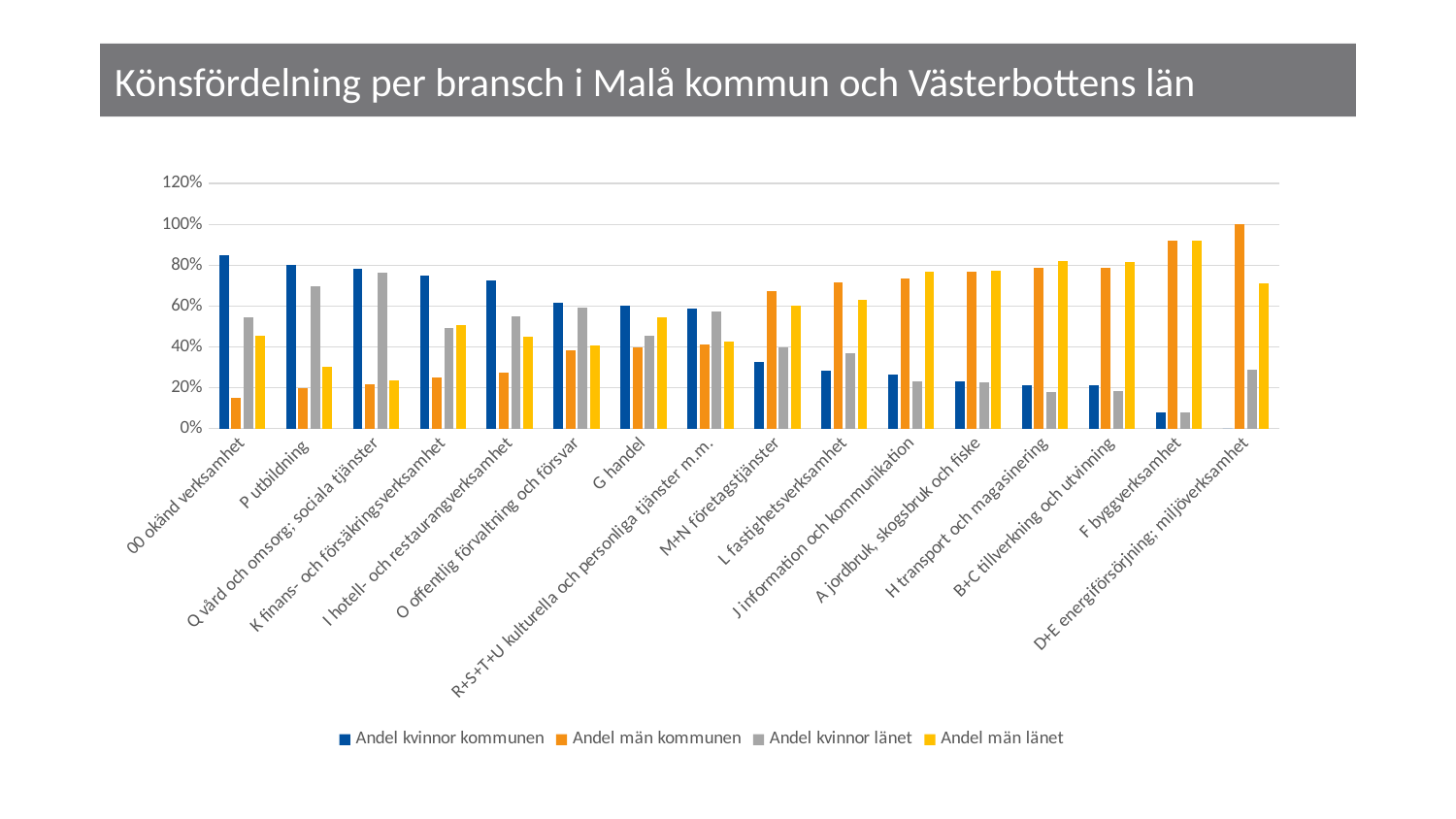
Is the value for Andel män länet in H transport och magasinering greater or less than 60%? greater What kind of chart is shown on the slide? Bar chart For G handel, which is larger: Andel kvinnor kommunen or Andel män kommunen? Andel kvinnor kommunen Do the values for Andel kvinnor kommunen generally rise or fall from left to right along the x axis? fall Which category has the highest value for Andel män kommunen? D+E energiförsörjning; miljöverksamhet Which category has the highest value for Andel män länet? F byggverksamhet How many series does the legend list? 4 Which category has the highest value for Andel kvinnor kommunen? 00 okänd verksamhet Which category has the lowest value for Andel män kommunen? 00 okänd verksamhet Is the value for Andel män kommunen in P utbildning greater or less than 40%? less Is the value for Andel kvinnor kommunen in 00 okänd verksamhet greater or less than 80%? greater How many industry categories are shown on the x axis? 16